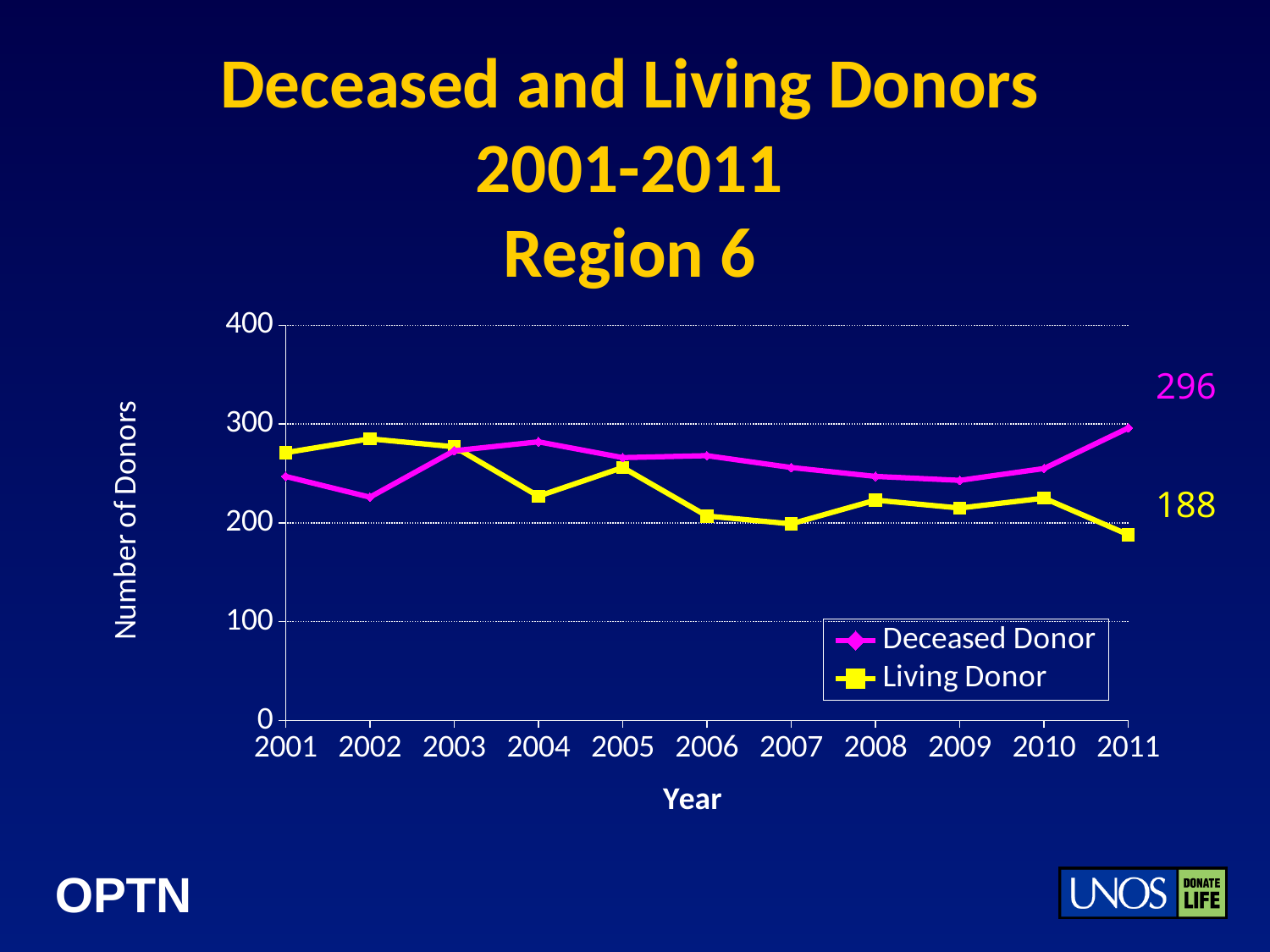
How many series does the legend list? 2 Is the value for Deceased Donor in 2009 greater or less than 200? greater Is the value for Deceased Donor in 2004 greater or less than 300? less In 2002, which series has the larger value, Deceased Donor or Living Donor? Living Donor What is the difference between the Deceased Donor and Living Donor values in 2011? 108 Does the Living Donor series rise or fall overall from 2001 to 2011? fall In 2011, which series has the larger value, Deceased Donor or Living Donor? Deceased Donor In which year is the Deceased Donor value highest? 2011 How many years are shown on the x axis? 11 What is the value for Deceased Donor in 2011? 296 What kind of chart is shown on the slide? line chart What is the value for Living Donor in 2011? 188